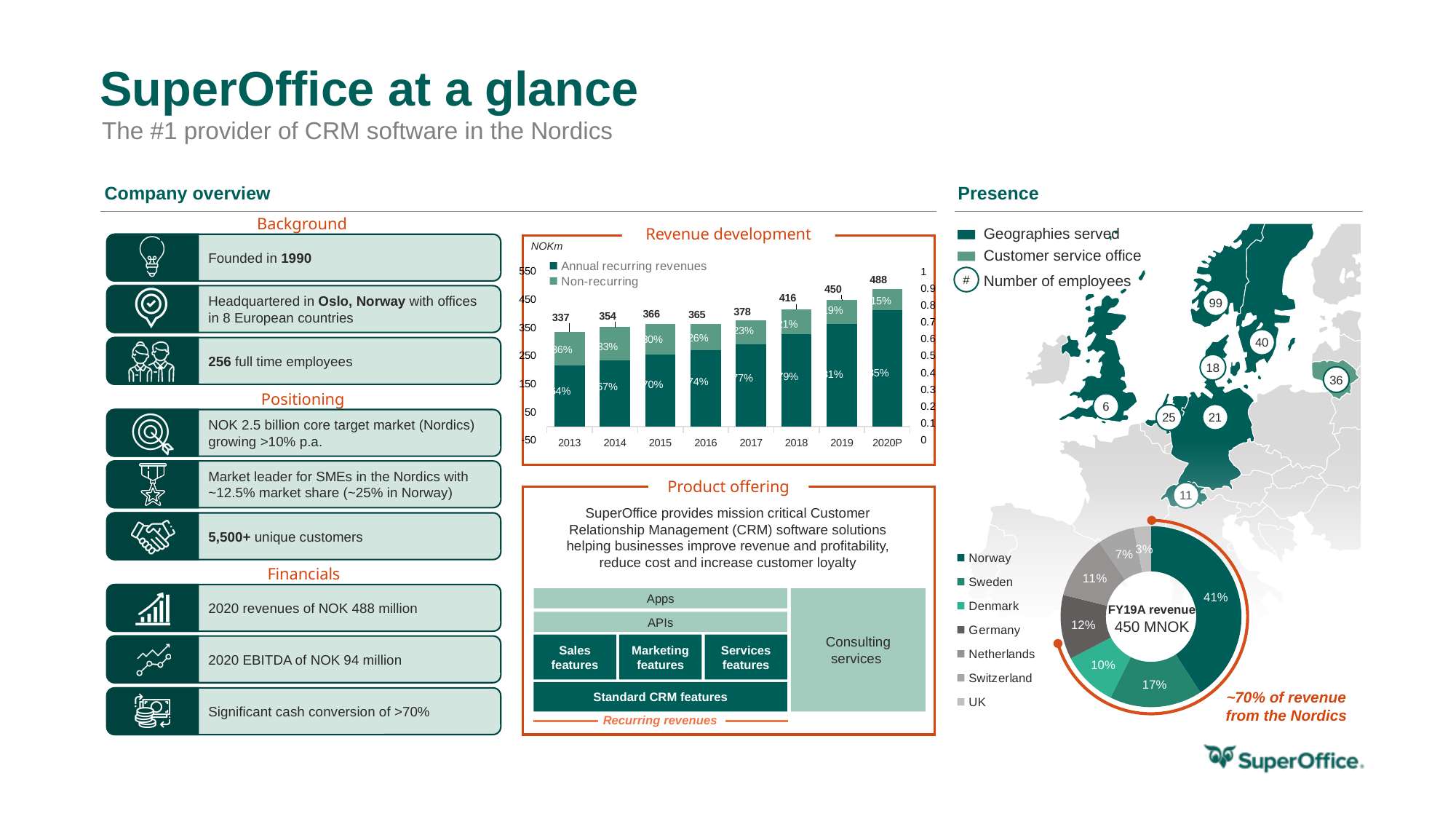
In the Revenue development chart, what is the difference between the total revenue for 2020P and 2019? 38 In the Revenue development chart, what is the total revenue shown for 2020P? 488 In the Revenue development chart, what is the total revenue shown for 2018? 416 In the Revenue development chart, which year has the lowest total revenue? 2013 In the FY19A revenue donut chart, which country has the smallest share? UK In the Revenue development chart, which year has the highest total revenue? 2020P In the Revenue development chart, how many series does the legend list? 2 In the FY19A revenue donut chart, how many countries does the legend list? 7 In the FY19A revenue donut chart, what share of revenue comes from Sweden? 17% In the Revenue development chart, do total revenues generally rise or fall from 2013 to 2020P? rise In the FY19A revenue donut chart, what share of revenue comes from Norway? 41% In the Revenue development chart, how many years are shown on the x axis? 8